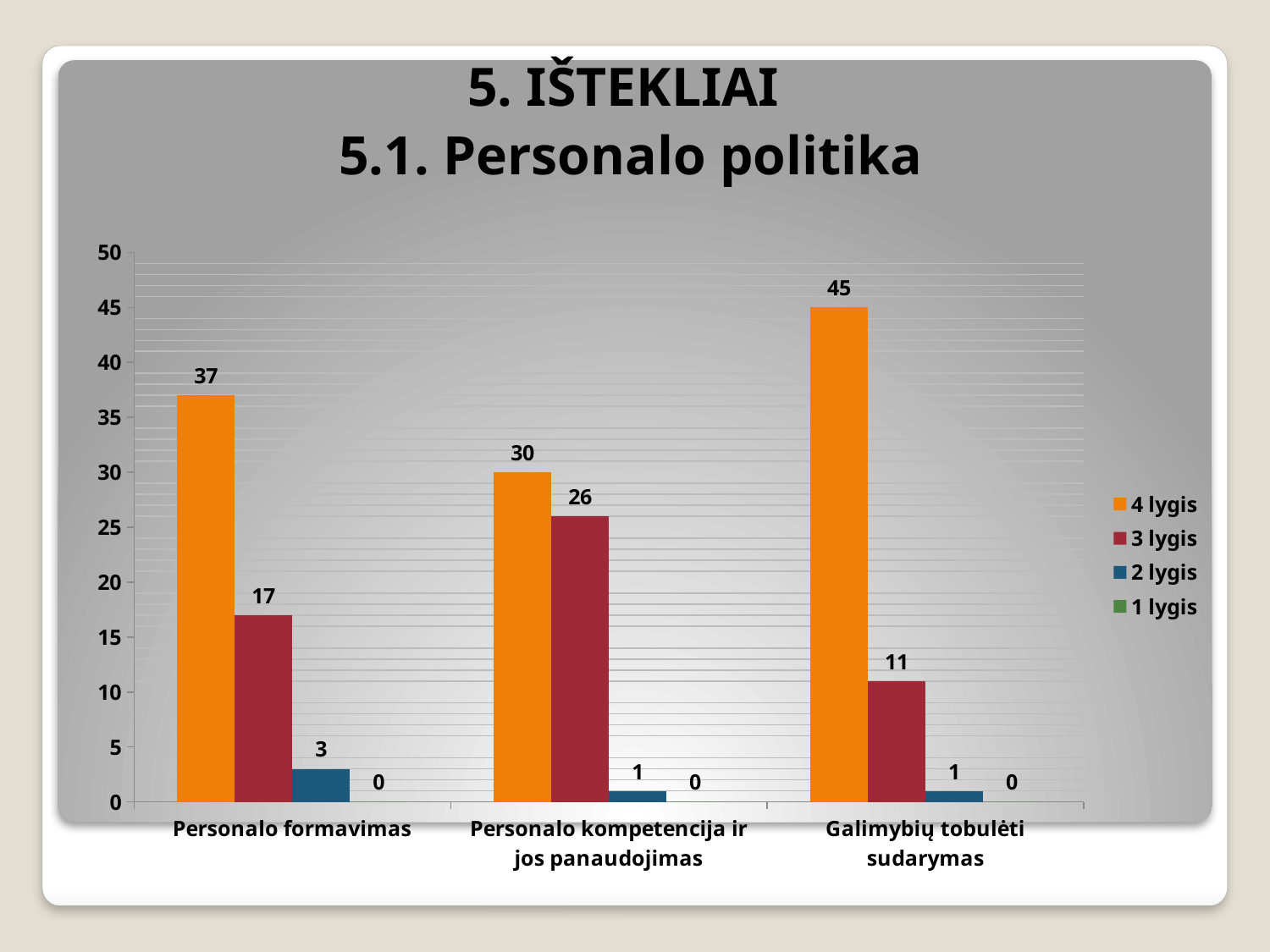
What is the value of the 4 lygis series for Personalo formavimas? 37 How many categories are shown on the x axis? 3 How many series does the legend list? 4 What kind of chart is shown on the slide? bar chart What is the value of the 1 lygis series for Personalo formavimas? 0 What is the value of the 3 lygis series for Personalo kompetencija ir jos panaudojimas? 26 What is the value of the 2 lygis series for Galimybių tobulėti sudarymas? 1 Which category has the lowest value for the 3 lygis series? Galimybių tobulėti sudarymas Which category has the highest value for the 4 lygis series? Galimybių tobulėti sudarymas What colour are the bars for the 4 lygis series? orange What is the difference between the 4 lygis and 3 lygis values for Personalo formavimas? 20 Which is larger: the 3 lygis value for Personalo kompetencija ir jos panaudojimas or the 3 lygis value for Personalo formavimas? Personalo kompetencija ir jos panaudojimas